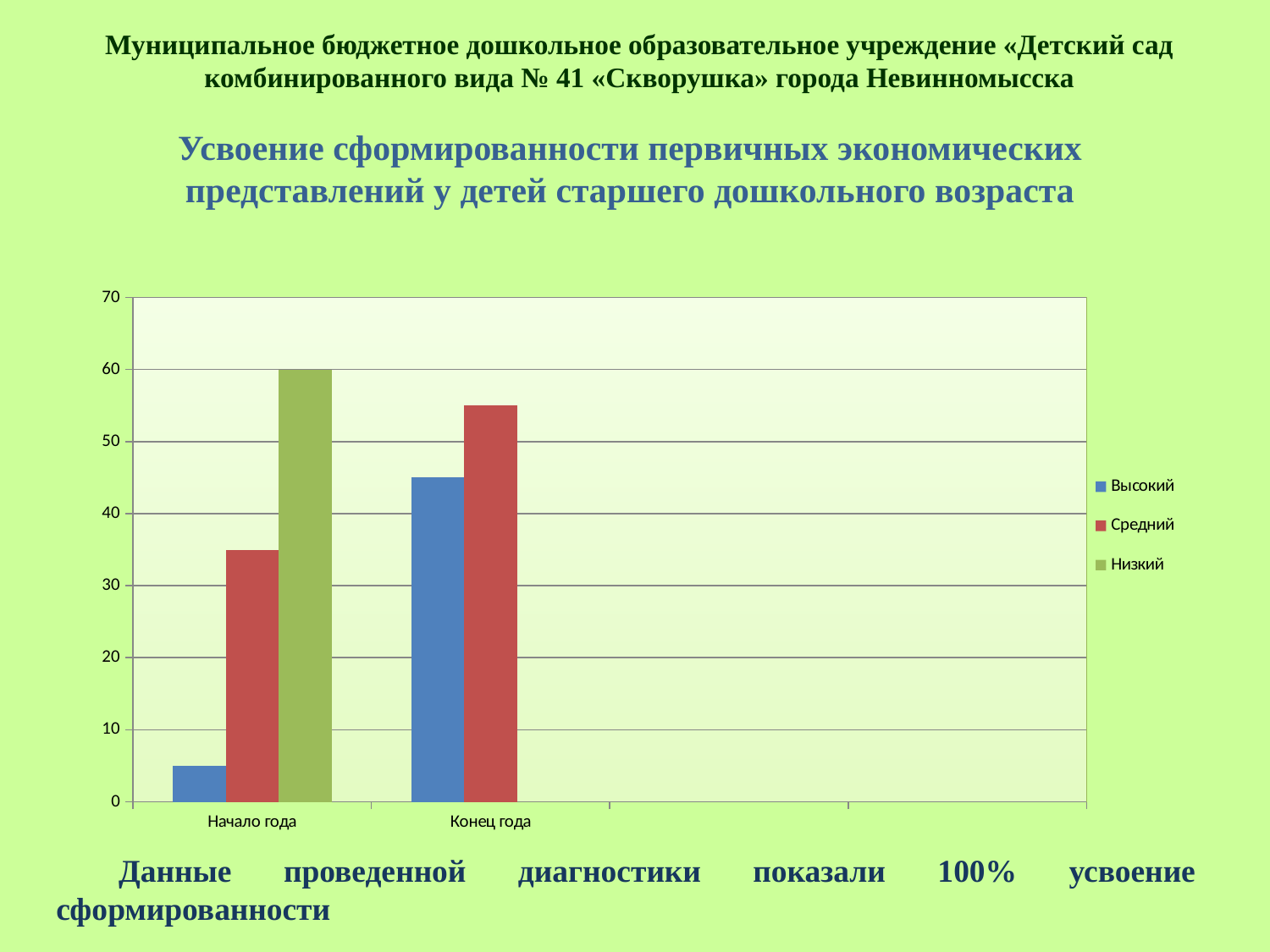
What is the value for Низкий at Начало года? 60 Is the value for Средний at Конец года greater or less than 50? greater Is the value for Высокий at Конец года greater or less than 40? greater What colour represents the Низкий series in the legend? green How many series does the legend list? 3 Which series has the highest value at Начало года? Низкий Is the value for Средний at Начало года greater or less than 30? greater How many categories are shown on the x axis? 2 Does the value for Высокий rise or fall from Начало года to Конец года? rises Which is larger: the value for Высокий at Начало года or at Конец года? Конец года What kind of chart is shown on the slide? bar chart